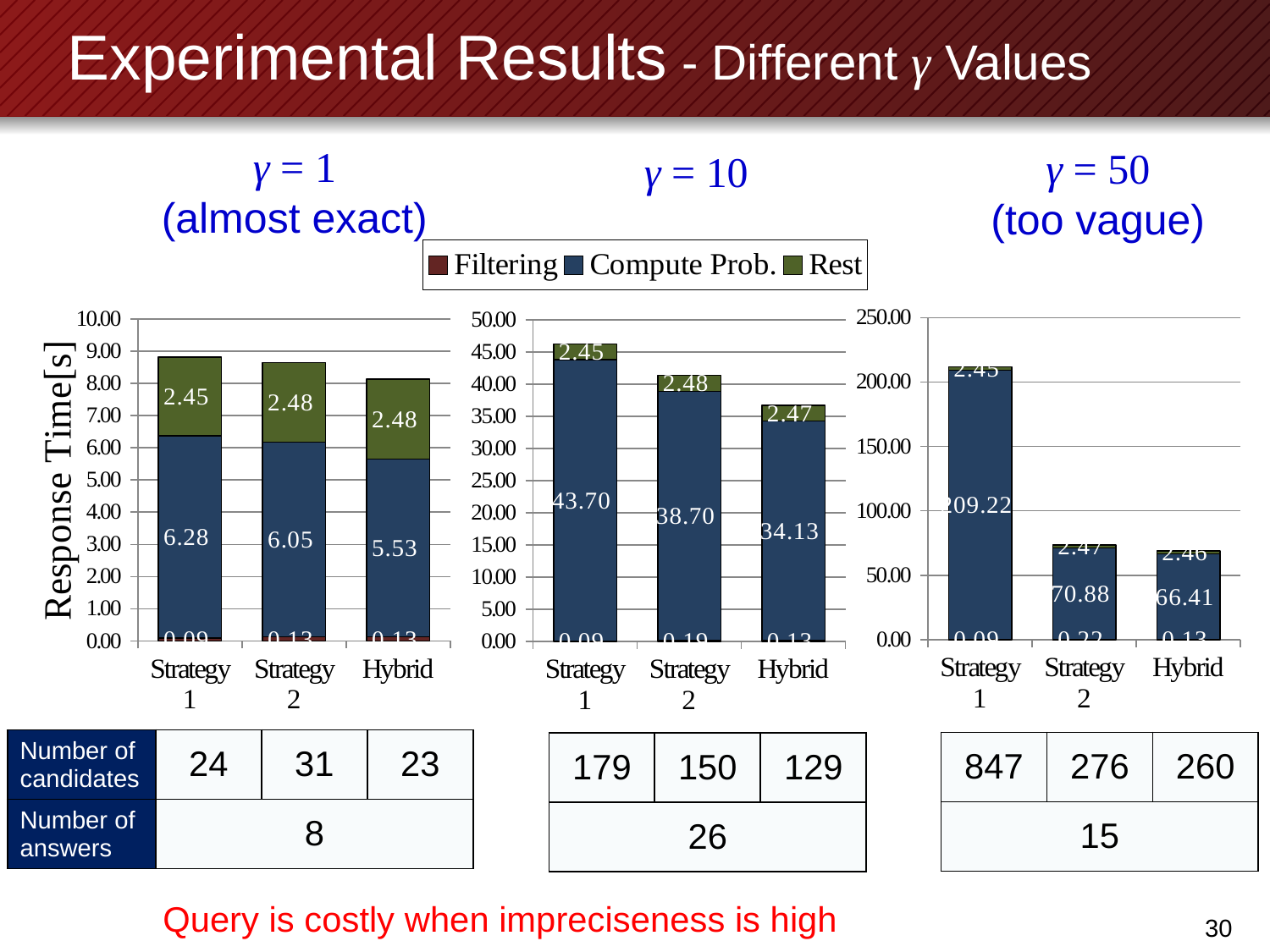
In the γ = 10 chart, what is the Compute Prob. value for Strategy 1? 43.70 In the γ = 1 chart, what is the Rest value for Hybrid? 2.48 In the γ = 50 chart, is the total bar height for Strategy 1 greater or less than 200? greater In the γ = 1 chart, which has the larger Compute Prob. value, Strategy 1 or Hybrid? Strategy 1 In the γ = 10 chart, what is the difference between the Compute Prob. values for Strategy 1 and Strategy 2? 5.00 In the γ = 50 chart, what is the Compute Prob. value for Hybrid? 66.41 In the γ = 50 chart, which category has the highest Compute Prob. value? Strategy 1 What kind of chart is the γ = 1 chart? stacked bar chart How many categories are shown on the x axis of the γ = 10 chart? 3 How many series does the legend list for the charts? 3 In the γ = 50 chart, what is the Compute Prob. value for Strategy 2? 70.88 In the γ = 10 chart, which category has the lowest Compute Prob. value? Hybrid